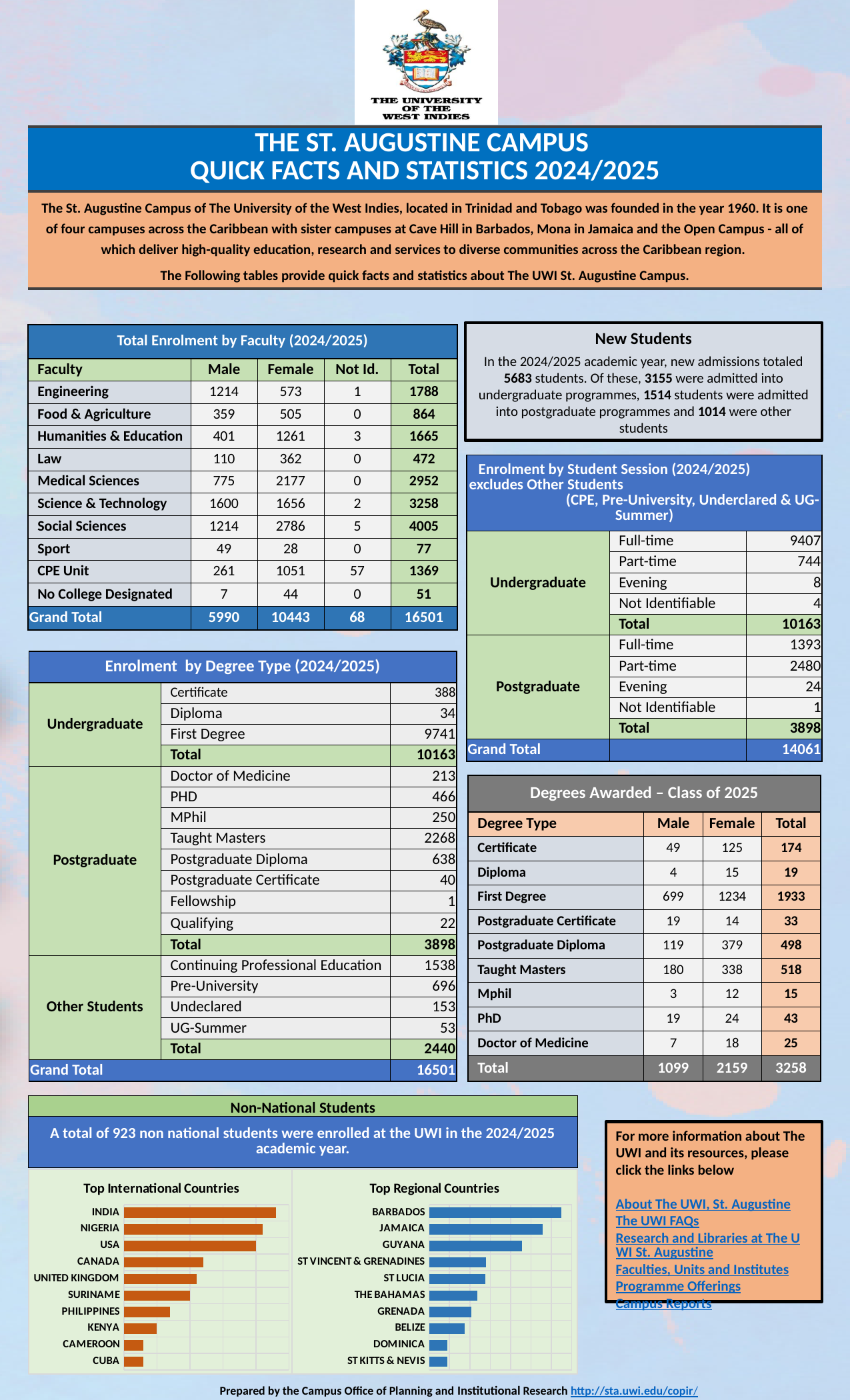
In the Top International Countries chart, which is larger, the value for Kenya or the value for Cameroon? Kenya In the Top International Countries chart, do the bar values increase or decrease from the top country to the bottom country? Decrease In the Top International Countries chart, which is larger, the value for India or the value for USA? India What colour are the bars in the Top International Countries chart? Orange Which country is listed second in the Top Regional Countries chart? Jamaica In the Top Regional Countries chart, which is larger, the value for Jamaica or the value for Guyana? Jamaica In the Top Regional Countries chart, which country has the highest value? Barbados How many countries are shown in the Top Regional Countries chart? 10 What kind of chart is the Top Regional Countries chart? Bar chart How many countries are shown in the Top International Countries chart? 10 In the Top International Countries chart, which country has the highest value? India